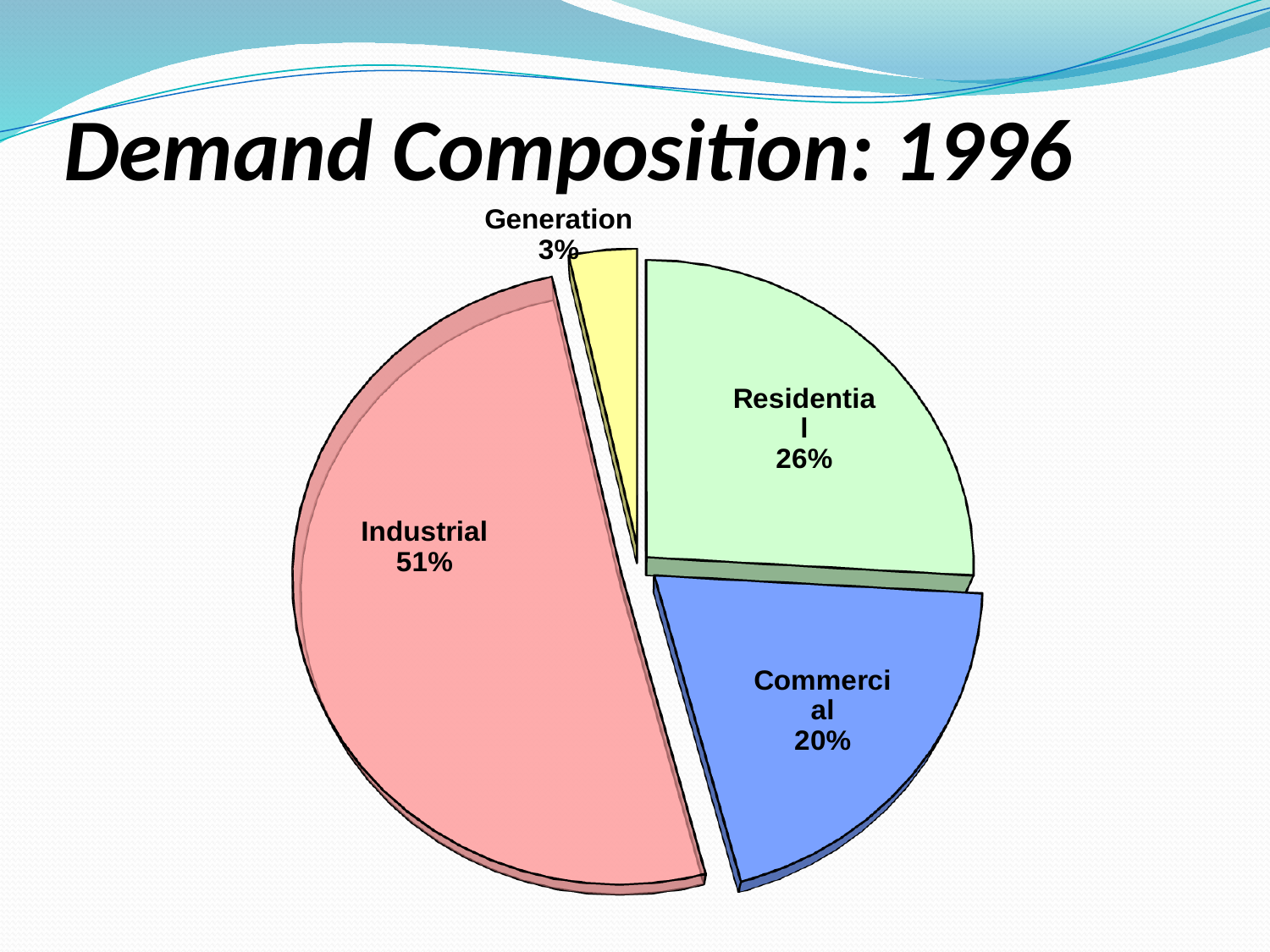
What percentage is shown for the Residential slice? 26% What is the difference in percentage points between the Industrial and Residential shares? 25 What percentage is shown for the Generation slice? 3% What percentage is shown for the Commercial slice? 20% Which category has the smallest share of the pie? Generation What is the difference in percentage points between the Residential and Commercial shares? 6 How many slices does the pie chart have? 4 What share of demand does the Industrial slice represent? 51% Which category has the largest share of the pie? Industrial What is the title of the slide? Demand Composition: 1996 Which is larger, the Commercial share or the Residential share? Residential What kind of chart is shown on the slide? Pie chart